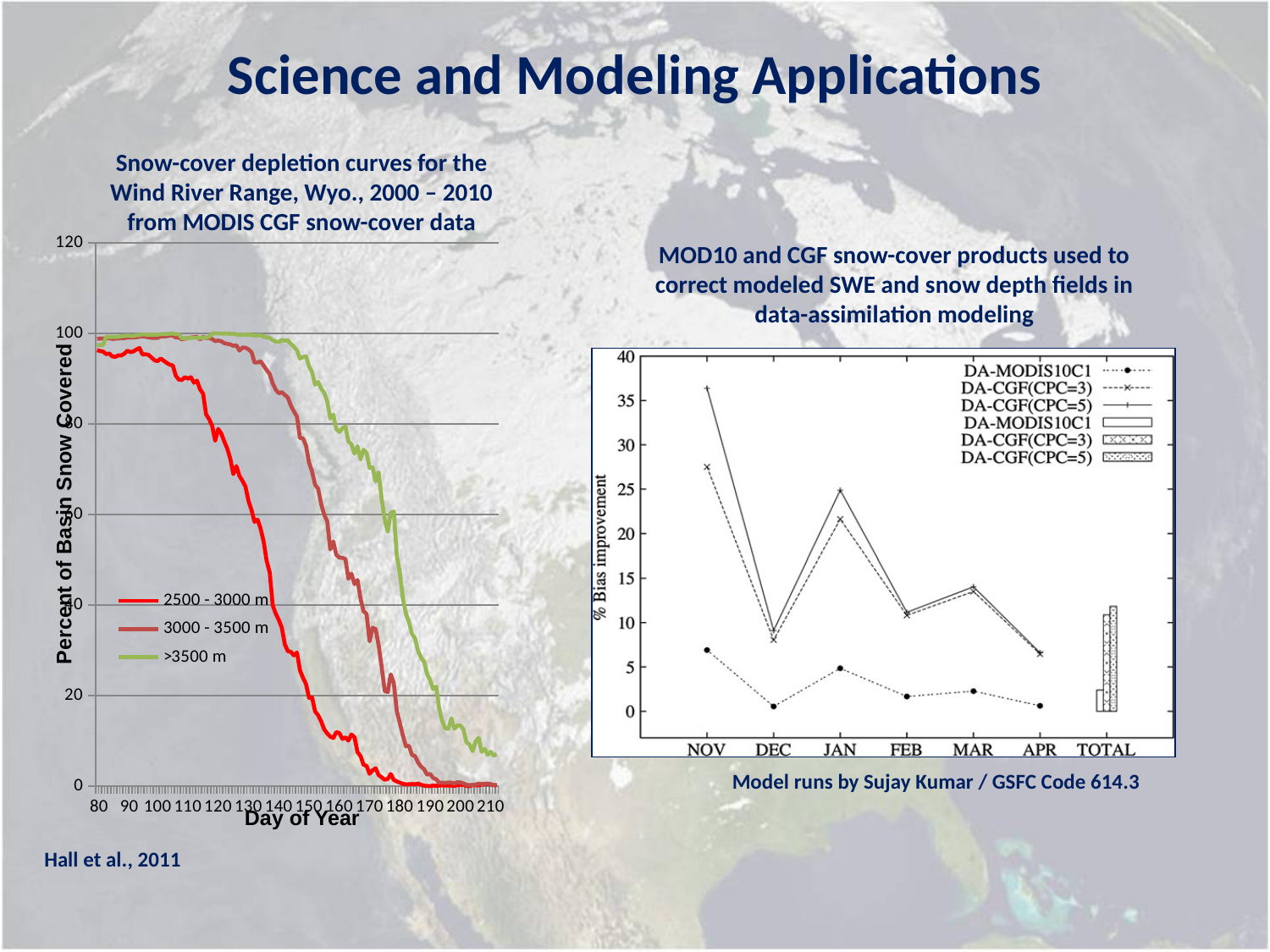
In the left chart (snow-cover depletion curves), is the value for the >3500 m series at day 170 greater or less than 40? greater In the right chart (% Bias improvement), how many categories are shown on the x axis? 7 In the right chart (% Bias improvement), in which month does the DA-CGF(CPC=5) line reach its highest value? NOV In the left chart (snow-cover depletion curves), what is the label of the x axis? Day of Year In the left chart (snow-cover depletion curves), how many elevation bands does the legend list? 3 In the left chart (snow-cover depletion curves), do the curves rise or fall as Day of Year increases? fall In the left chart (snow-cover depletion curves), is the value for the 3000 - 3500 m series at day 140 greater or less than 60? greater In the left chart (snow-cover depletion curves), is the value for the 2500 - 3000 m series at day 180 greater or less than 20? less In the right chart (% Bias improvement), how many entries does the legend list? 6 What type of chart is the left chart, 'Snow-cover depletion curves for the Wind River Range'? line chart In the left chart (snow-cover depletion curves), which series reaches 0 percent snow cover first: 2500 - 3000 m or >3500 m? 2500 - 3000 m